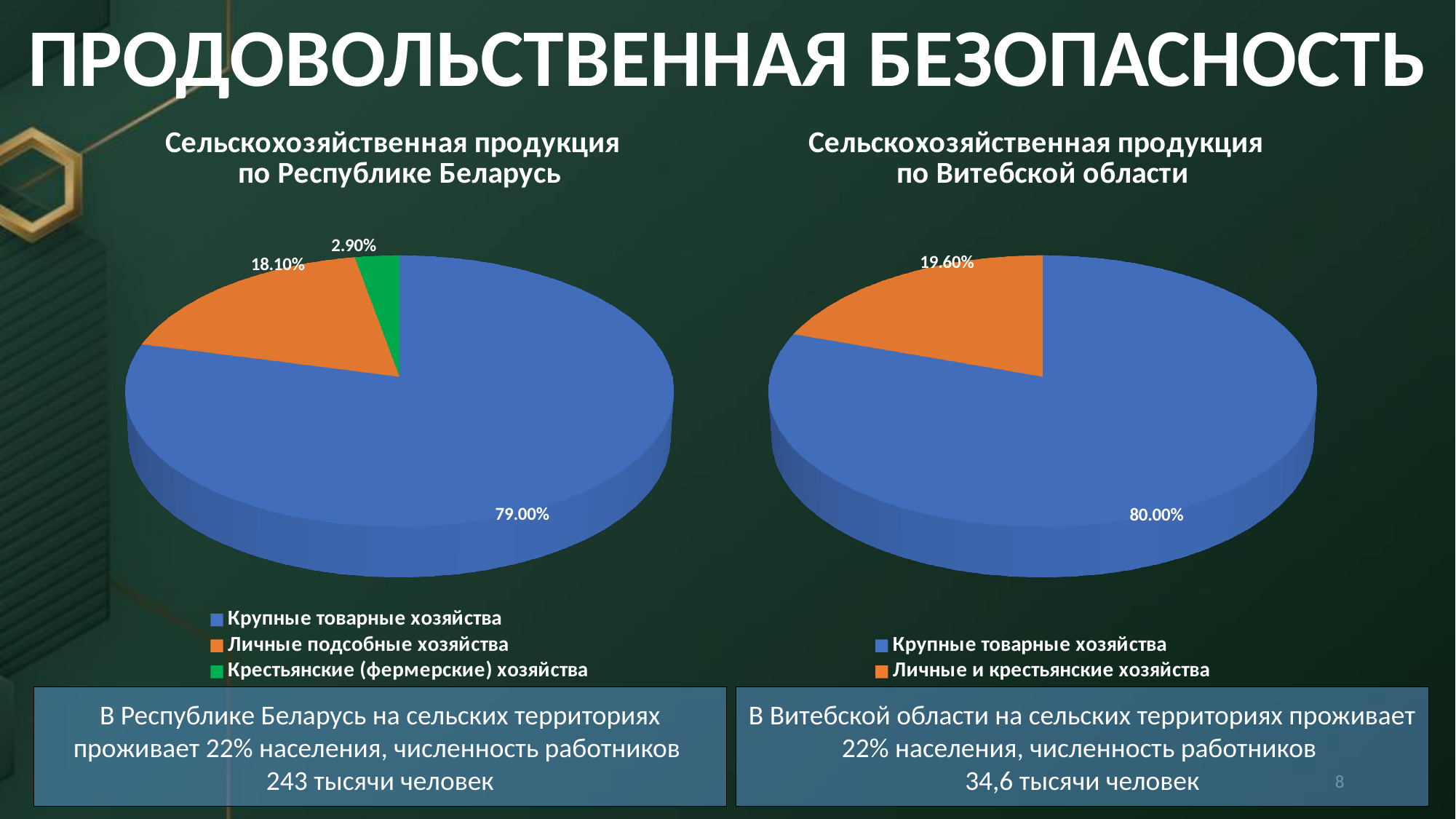
In the chart 'Сельскохозяйственная продукция по Республике Беларусь', what share is shown for Крупные товарные хозяйства? 79.00% In the chart 'Сельскохозяйственная продукция по Витебской области', which category has the largest slice? Крупные товарные хозяйства In the chart 'Сельскохозяйственная продукция по Республике Беларусь', what share is shown for Крестьянские (фермерские) хозяйства? 2.90% In the chart 'Сельскохозяйственная продукция по Республике Беларусь', which category has the smallest slice? Крестьянские (фермерские) хозяйства In the chart 'Сельскохозяйственная продукция по Витебской области', what is the difference between the shares of Крупные товарные хозяйства and Личные и крестьянские хозяйства? 60.40% How many slices does the chart 'Сельскохозяйственная продукция по Республике Беларусь' have? 3 In the chart 'Сельскохозяйственная продукция по Витебской области', what share is shown for Личные и крестьянские хозяйства? 19.60% What type of chart is 'Сельскохозяйственная продукция по Витебской области'? Pie chart In the chart 'Сельскохозяйственная продукция по Республике Беларусь', what is the difference between the shares of Крупные товарные хозяйства and Личные подсобные хозяйства? 60.90% How many entries does the legend of the chart 'Сельскохозяйственная продукция по Витебской области' list? 2 In the chart 'Сельскохозяйственная продукция по Республике Беларусь', what share is shown for Личные подсобные хозяйства? 18.10% In the chart 'Сельскохозяйственная продукция по Витебской области', what share is shown for Крупные товарные хозяйства? 80.00%